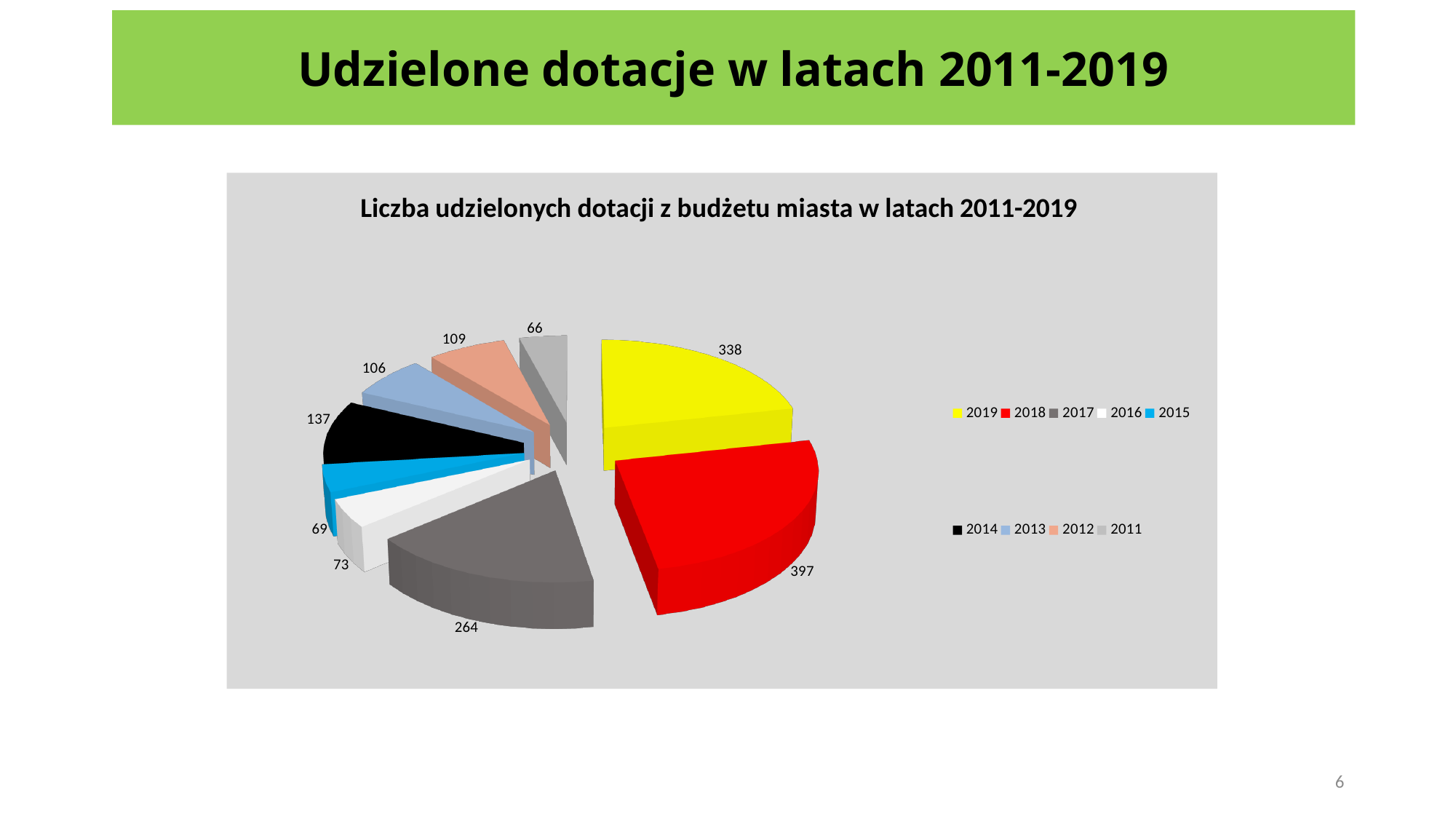
Which year has the smallest slice in the pie chart? 2011 What value is shown for 2017 in the pie chart? 264 Which year has the largest slice in the pie chart? 2018 How many grants (dotacje) were awarded in 2018 according to the pie chart? 397 What is the number of grants shown for 2014? 137 How many years (slices) are shown in the pie chart? 9 What is the difference between the values for 2018 and 2019? 59 What value does the pie chart show for 2011? 66 Which year has the higher value, 2012 or 2013? 2012 What colour is the slice for 2019 in the pie chart? Yellow What type of chart is shown on the slide? Pie chart What is the difference between the values for 2017 and 2014? 127